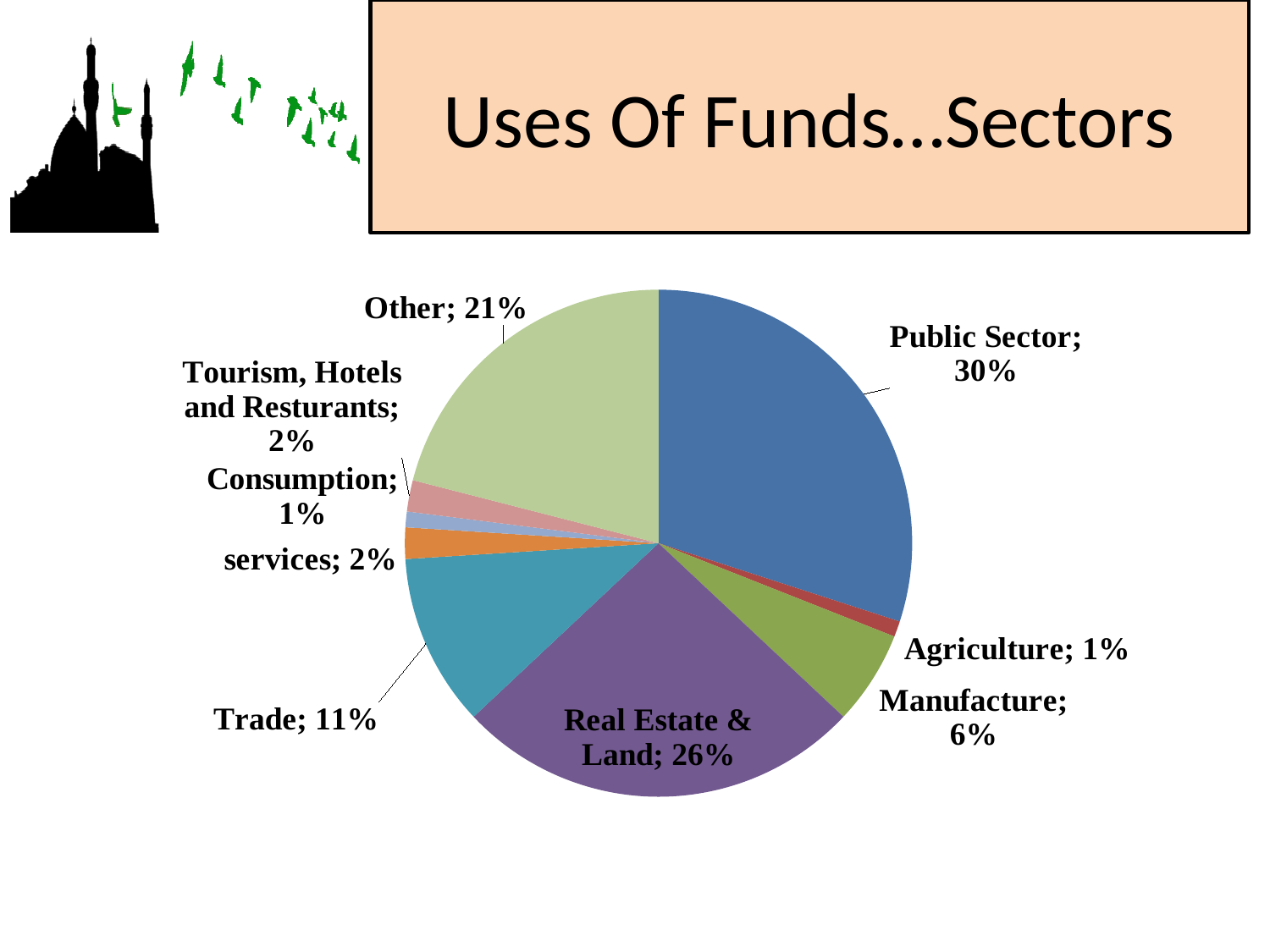
What share of funds goes to Trade? 11% What share of funds goes to Real Estate & Land? 26% Which is larger, the share for Other or the share for Trade? Other What share of funds goes to the Public Sector? 30% How many sectors (slices) are shown in the pie chart? 9 What is the difference between the Other share and the Manufacture share? 15% What share of funds goes to Manufacture? 6% What kind of chart is shown on the slide? pie chart What is the title of the slide containing the chart? Uses Of Funds…Sectors What share of funds goes to Tourism, Hotels and Resturants? 2% What is the difference between the Public Sector share and the Real Estate & Land share? 4% Which sector has the largest share of funds? Public Sector